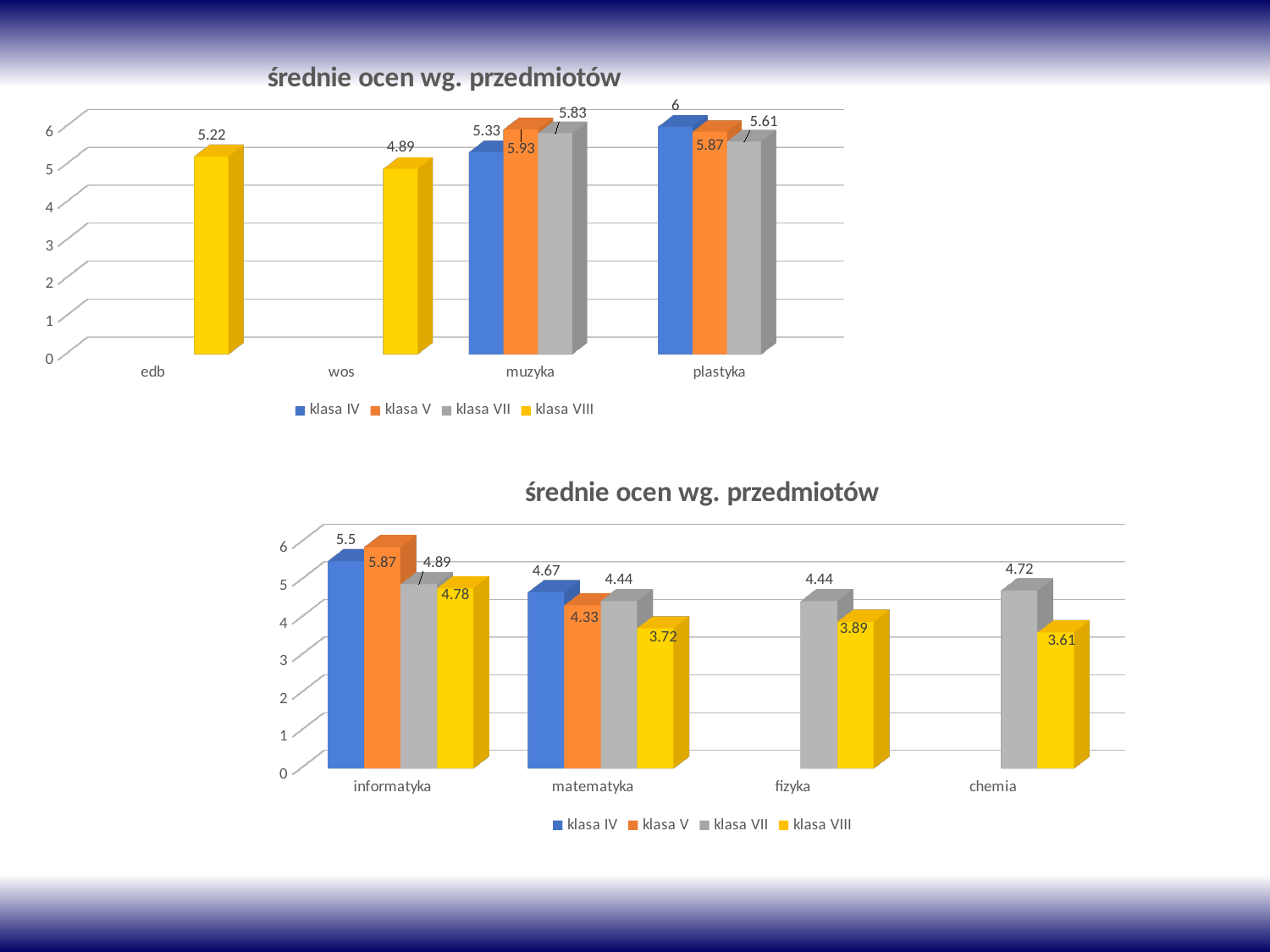
In the bottom chart, which series has the lowest value in informatyka? klasa VIII In the top chart, what is the value for klasa IV in plastyka? 6 How many series does the legend of the bottom chart list? 4 In the top chart, what is the value for klasa V in muzyka? 5.93 In the bottom chart, what is the value for klasa V in matematyka? 4.33 In the top chart, how many categories are shown on the x axis? 4 In the bottom chart, which is larger in fizyka: klasa VII or klasa VIII? klasa VII In the top chart, which series has the highest value in plastyka? klasa IV In the bottom chart, what is the difference between klasa IV and klasa VIII in matematyka? 0.95 In the top chart, what is the difference between klasa V and klasa VII in muzyka? 0.1 In the bottom chart, what is the value for klasa VIII in chemia? 3.61 In the top chart, what is the value for klasa VIII in edb? 5.22